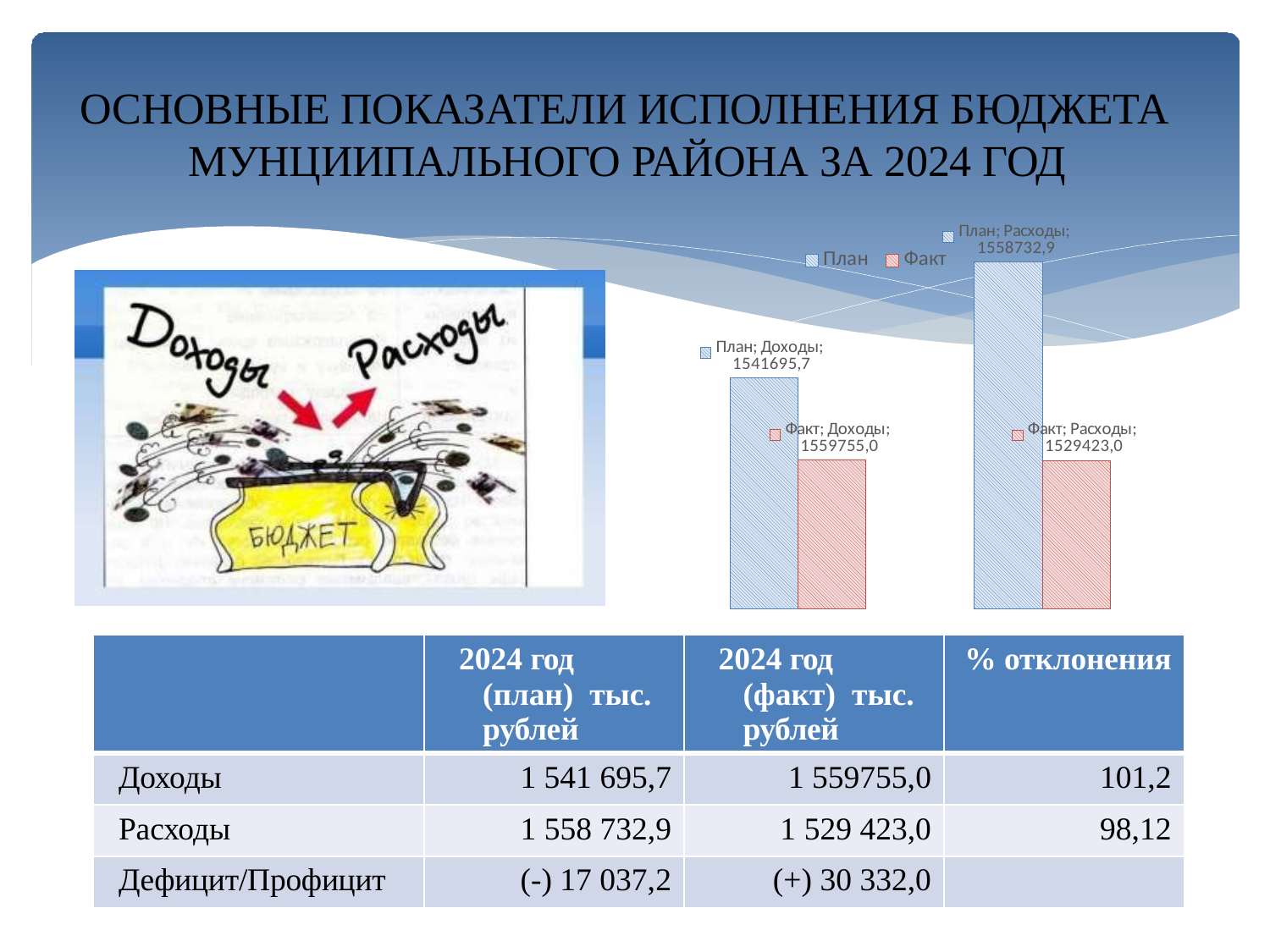
Which series in the chart is drawn with red hatched bars? Факт What is the value of the Факт series for Расходы in the chart? 1529423,0 By how much does the Факт value for Доходы exceed the План value for Доходы in the chart? 18059,3 How many categories are plotted in the chart? 2 What is the value of the План series for Доходы in the chart? 1541695,7 How many series does the chart legend list? 2 What is the value of the План series for Расходы in the chart? 1558732,9 What kind of chart is shown on the slide? Bar chart What is the difference between the План and Факт values for Расходы in the chart? 29309,9 What are the two series names shown in the chart legend? План and Факт What is the value of the Факт series for Доходы in the chart? 1559755,0